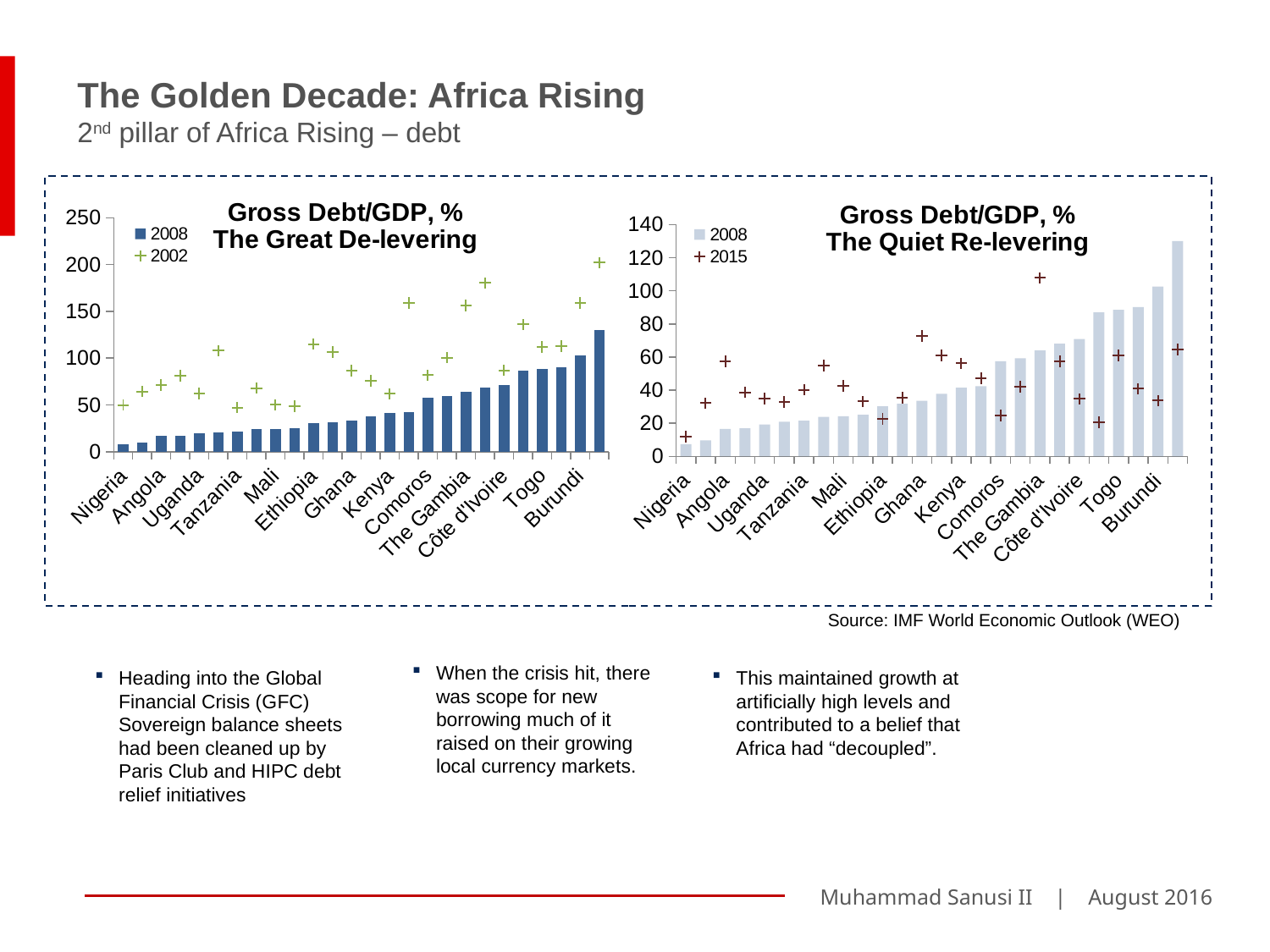
How many series does the legend of the left chart, 'The Great De-levering', list? 2 Which two years are listed in the legend of the right chart, 'The Quiet Re-levering'? 2008 and 2015 What source is cited for the charts on the slide? IMF World Economic Outlook (WEO) In the left chart, 'The Great De-levering', is the 2008 value for Nigeria greater or less than 50? less In the left chart, 'The Great De-levering', which labelled country has the highest 2008 bar? Burundi In the right chart, 'The Quiet Re-levering', which labelled country has the highest 2008 bar? Burundi In the left chart, 'The Great De-levering', is Burundi's 2002 value or its 2008 value larger? 2002 What kind of chart is the left chart, 'The Great De-levering'? bar chart In the right chart, 'The Quiet Re-levering', do the 2008 bars rise or fall from left to right? rise In the left chart, 'The Great De-levering', which labelled country has the lowest 2008 bar? Nigeria